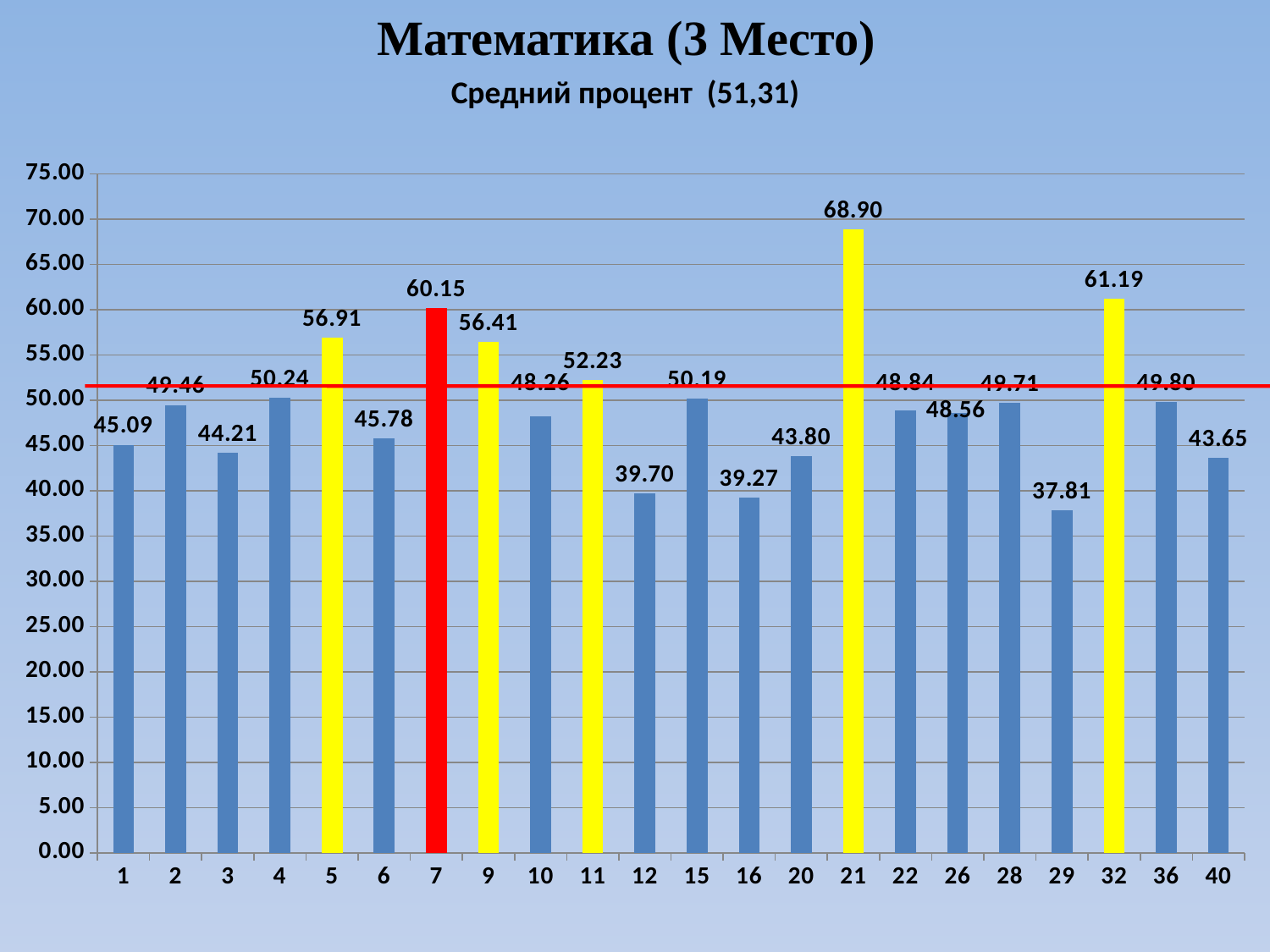
Which has a larger value, category 4 or category 3? 4 What is the difference between the values for categories 21 and 32? 7.71 What kind of chart is shown on the slide? bar chart What average percentage is stated in the chart subtitle? 51,31 Is the value for category 16 greater or less than 40.00? less What is the value for category 21? 68.90 What is the value for category 7, the red bar? 60.15 What is the difference between the values for categories 7 and 5? 3.24 How many categories are shown on the x axis? 22 Which category has the lowest value? 29 What is the value for category 29? 37.81 Which category has the highest value? 21